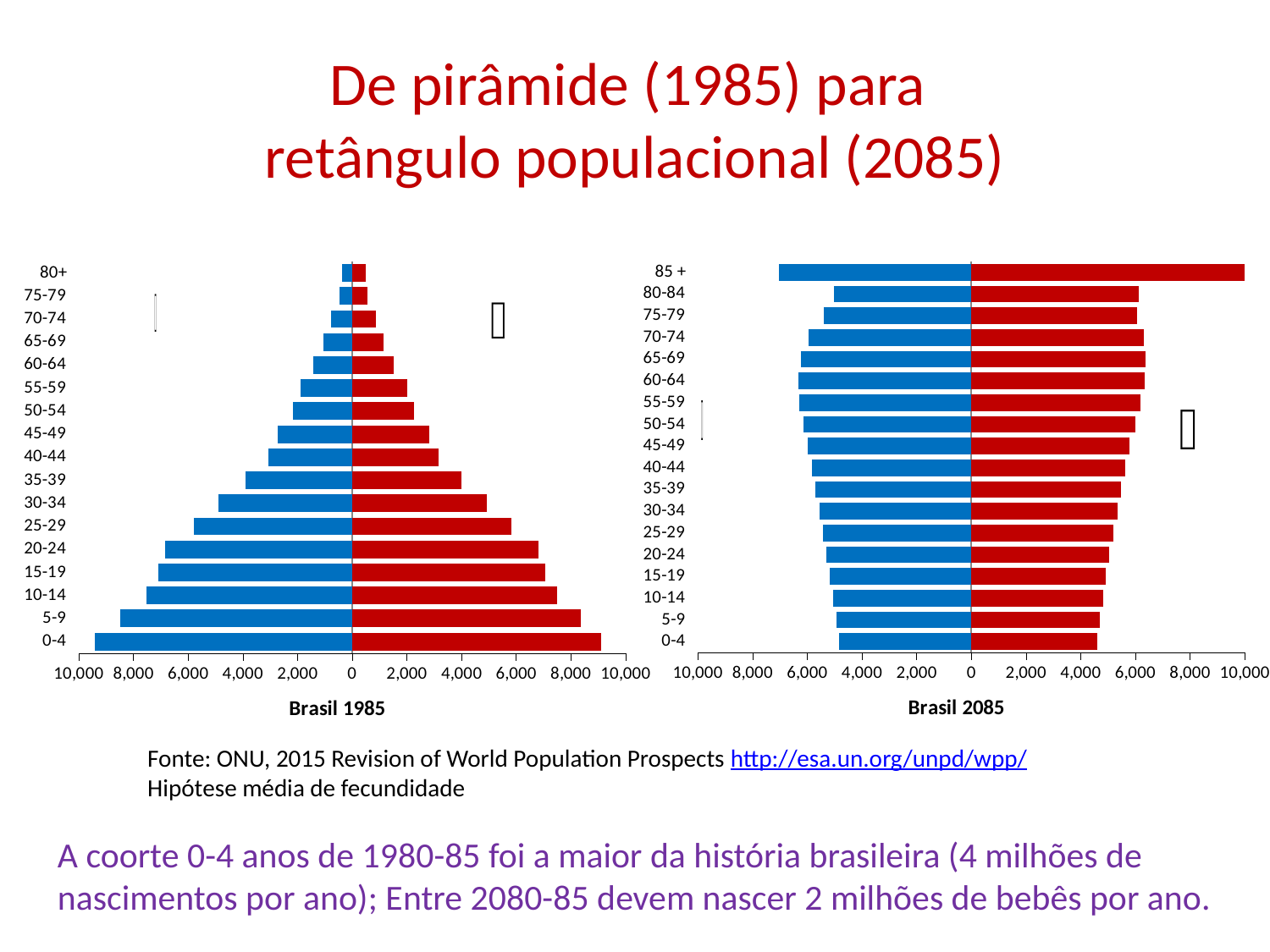
On the Brasil 1985 chart, which red bar is longer: 0-4 or 40-44? 0-4 On the Brasil 1985 chart, which age group has the shortest bars? 80+ On the Brasil 2085 chart, is the red bar for the 85 + age group greater or less than 8,000? greater On the Brasil 2085 chart, which age group has the longest bars? 85 + On the Brasil 1985 chart, do the bars get longer or shorter as the age group increases from 0-4 to 80+? shorter How many age groups are shown on the Brasil 1985 chart? 17 On the Brasil 1985 chart, is the red bar for the 80+ age group greater or less than 2,000? less On the Brasil 1985 chart, is the red bar for the 0-4 age group greater or less than 8,000? greater What kind of chart is the Brasil 1985 chart? bar chart On the Brasil 1985 chart, which age group has the longest bars? 0-4 How many age groups are shown on the Brasil 2085 chart? 18